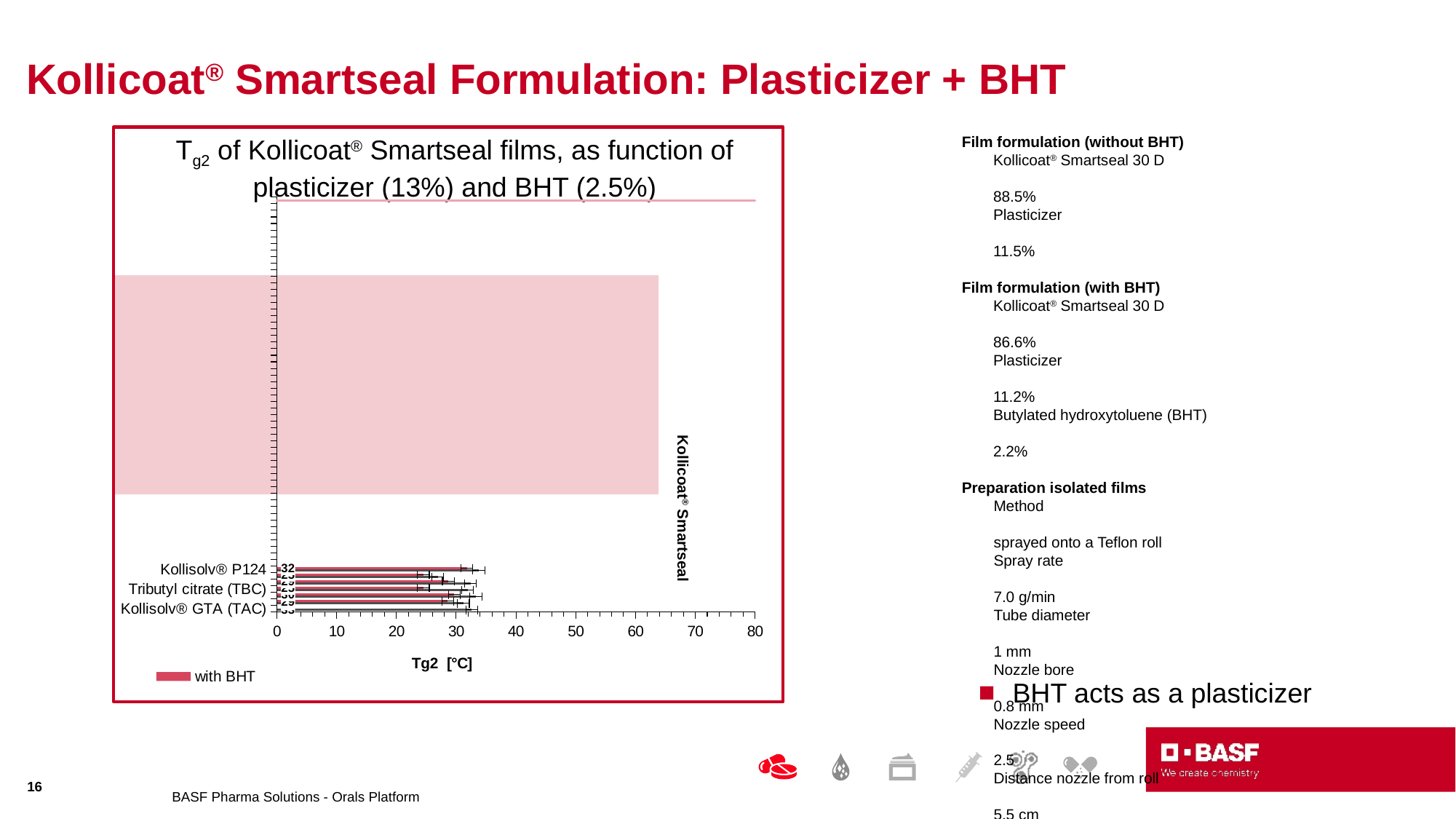
What kind of chart is shown on the slide? bar chart Is the value for Kollisolv® P124 greater or less than 40? less Is the value for Tributyl citrate (TBC) greater or less than 40? less What is the Tg2 value labelled for Kollisolv® P124? 32 Is the value for Kollisolv® GTA (TAC) greater or less than 50? less What is the series name shown in the chart legend? with BHT How many series does the chart legend list? 1 What is the title of the x axis of the chart? Tg2 [°C] What is the highest tick value shown on the x axis of the chart? 80